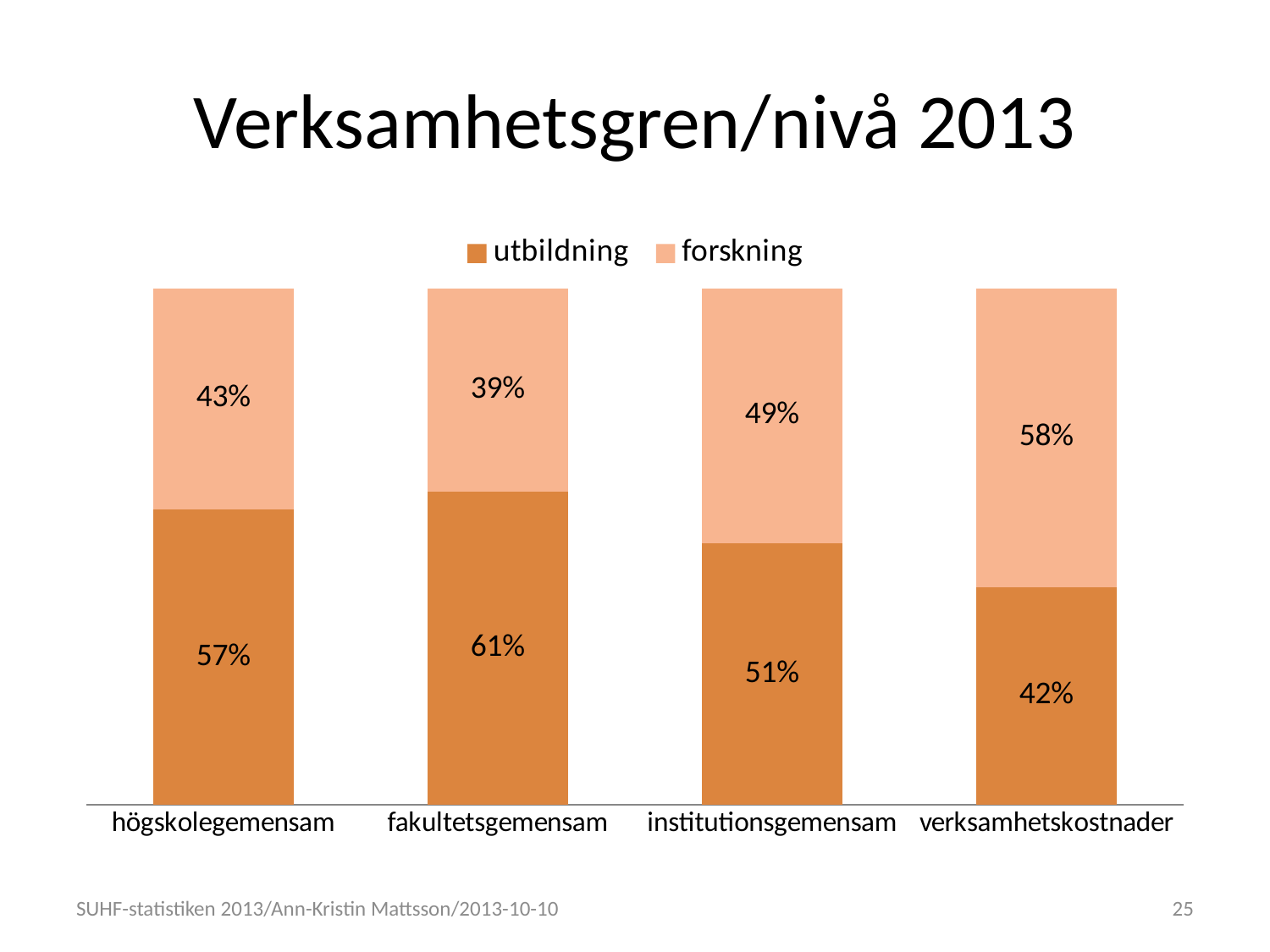
What kind of chart is shown on the slide? stacked bar chart What is the utbildning value for verksamhetskostnader? 42% What is the forskning value for fakultetsgemensam? 39% Which is larger for institutionsgemensam, utbildning or forskning? utbildning What is the utbildning value for högskolegemensam? 57% Which category has the highest utbildning share? fakultetsgemensam How many series does the legend list? 2 What is the title of the chart? Verksamhetsgren/nivå 2013 How many categories are shown on the x axis? 4 Which category has the lowest forskning share? fakultetsgemensam What is the forskning value for institutionsgemensam? 49% What is the difference between the utbildning and forskning values for verksamhetskostnader? 16%